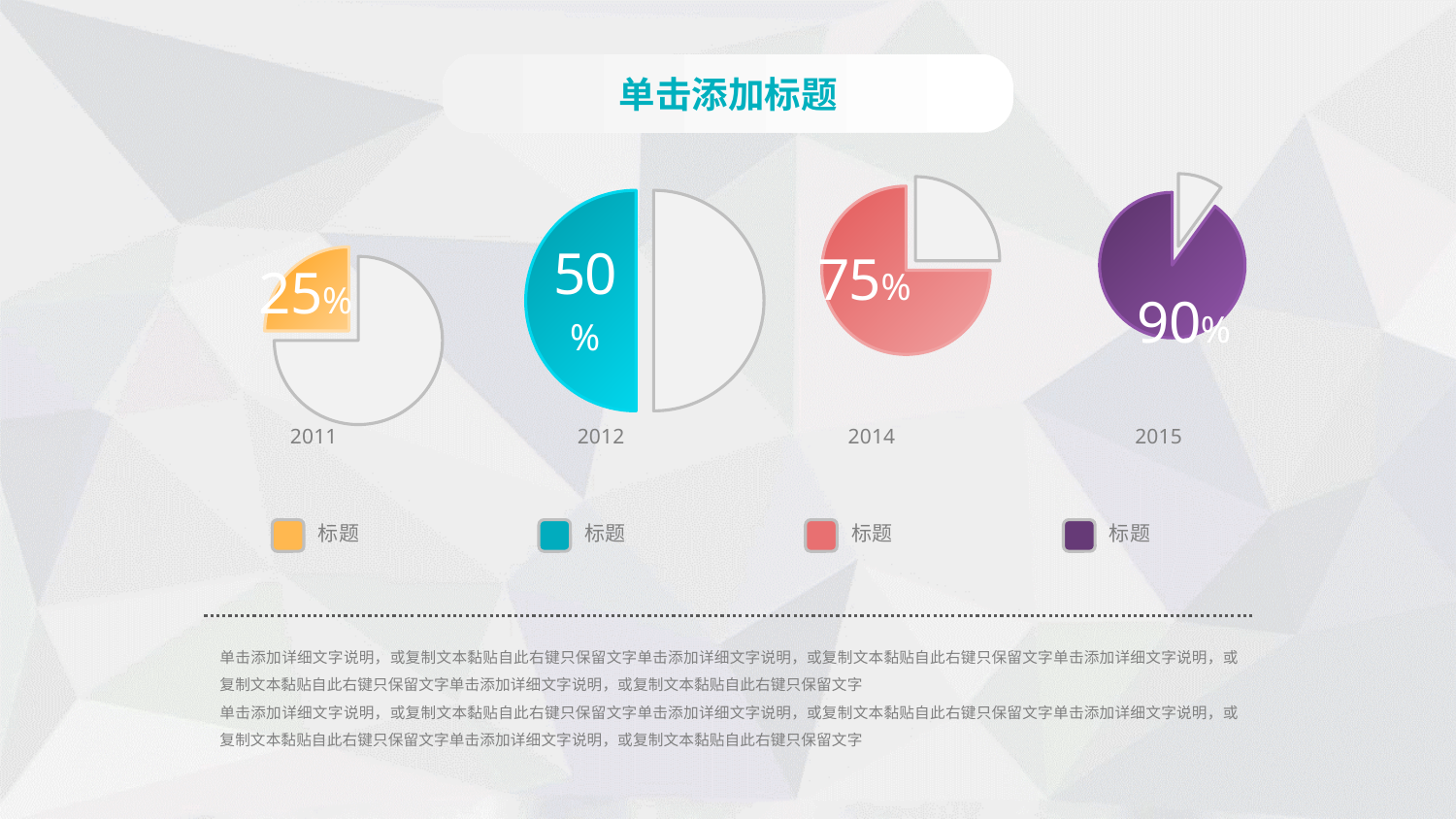
Which year's pie chart shows the highest percentage? 2015 What kind of chart is used to show the percentage for each year? Pie chart What percentage is shown on the pie chart labelled 2015? 90% What percentage is shown on the pie chart labelled 2012? 50% What is the difference between the percentage shown for 2015 and the percentage shown for 2011? 65% What colour is the filled slice of the pie chart labelled 2014? Red What percentage is shown on the pie chart labelled 2011? 25% Which year's pie chart shows the lowest percentage? 2011 Do the percentages rise or fall from 2011 to 2015 across the pie charts? Rise How many pie charts are shown on the slide? 4 What percentage is shown on the pie chart labelled 2014? 75% Which shows a larger percentage, the 2012 pie chart or the 2014 pie chart? 2014